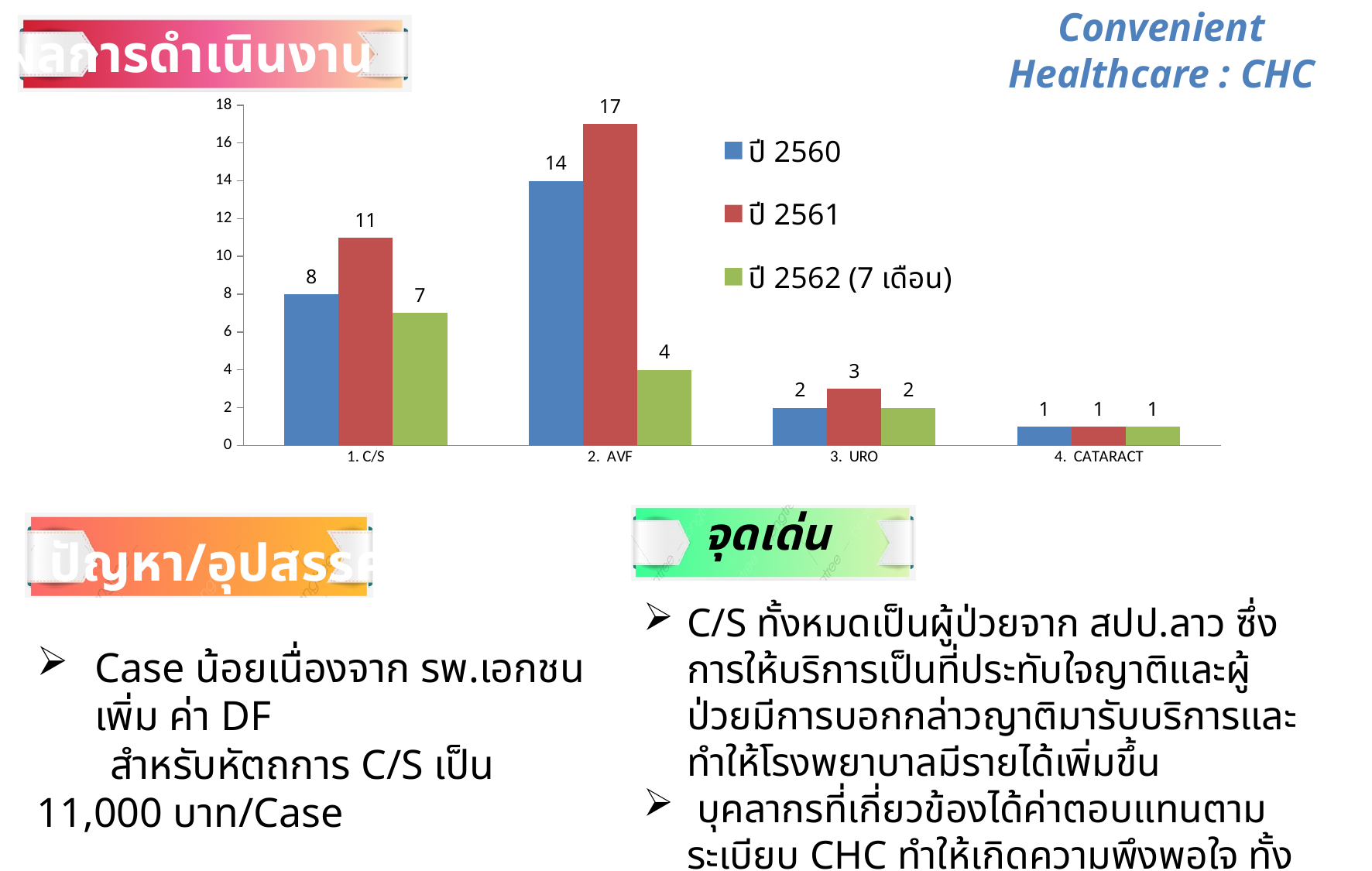
Which series is shown in green in the chart legend? ปี 2562 (7 เดือน) Which category has the lowest value in the ปี 2561 series? 4. CATARACT What is the difference between the ปี 2561 and ปี 2560 values for 1. C/S? 3 What is the value for 2. AVF in the ปี 2561 series? 17 What is the value for 1. C/S in the ปี 2562 (7 เดือน) series? 7 Which is larger for 1. C/S: the ปี 2560 value or the ปี 2562 (7 เดือน) value? ปี 2560 How many series does the chart legend list? 3 How many categories are shown on the x axis of the chart? 4 What is the difference between the ปี 2561 and ปี 2562 (7 เดือน) values for 2. AVF? 13 Which category has the highest value in the ปี 2560 series? 2. AVF What type of chart is shown on the slide? bar chart What is the value for 3. URO in the ปี 2560 series? 2